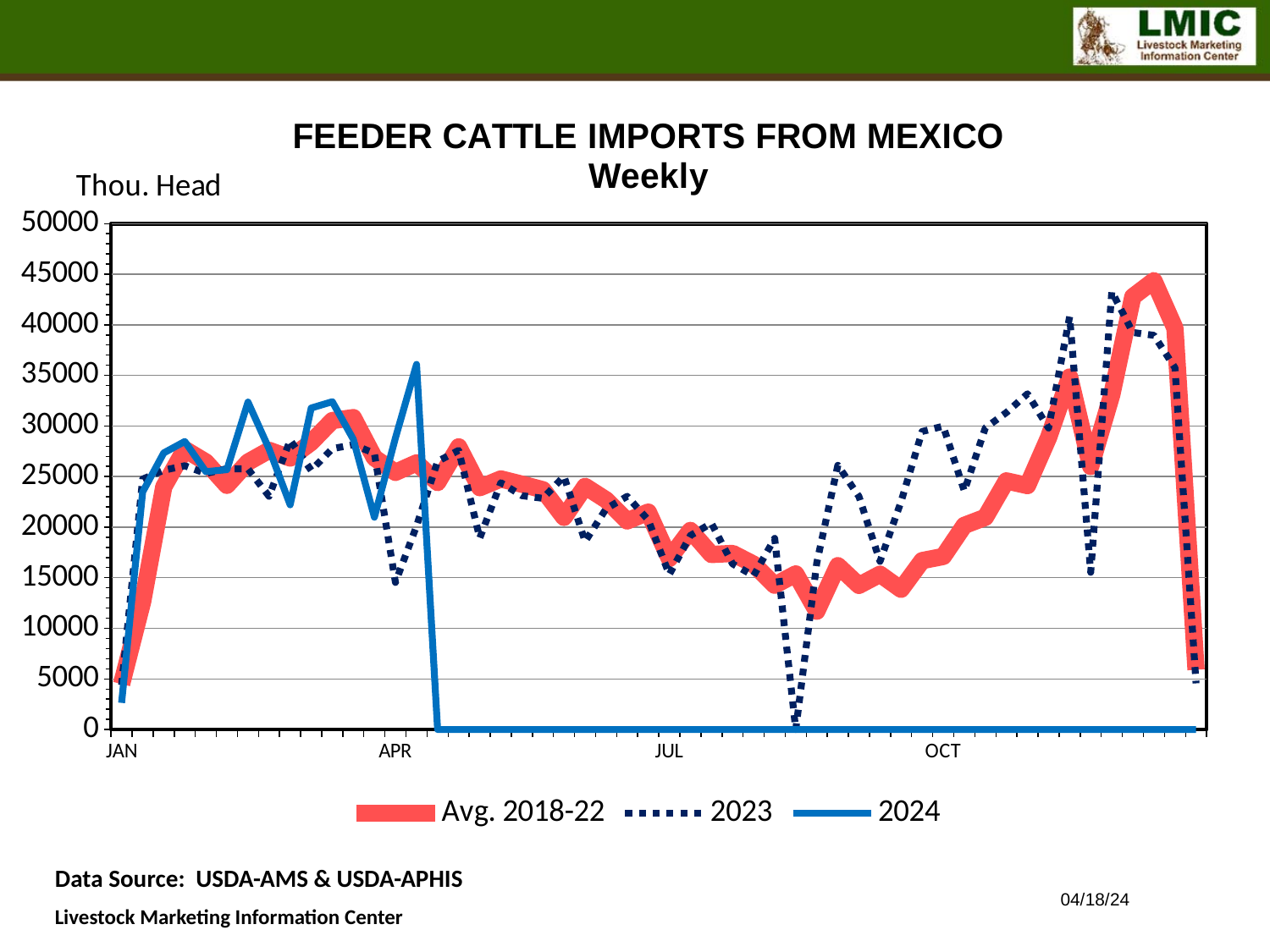
Just after APR, which series is higher: 2024 or 2023? 2024 Is the lowest value of the Avg. 2018-22 series, between JUL and OCT, greater or less than 15000? less Does the Avg. 2018-22 series rise or fall from OCT to its peak near the end of the year? rise Is the lowest value of the 2023 series, in the dip between JUL and OCT, greater or less than 5000? less Is the peak value of the 2024 series, reached just after APR, greater or less than 30000? greater What kind of chart is shown on the slide? line chart At the peak near the end of the year, which series is higher: Avg. 2018-22 or 2023? Avg. 2018-22 What unit label is shown on the y axis? Thou. Head Does the Avg. 2018-22 series rise or fall from JUL to early September? fall How many series does the legend list? 3 What is the title of the chart? FEEDER CATTLE IMPORTS FROM MEXICO Weekly